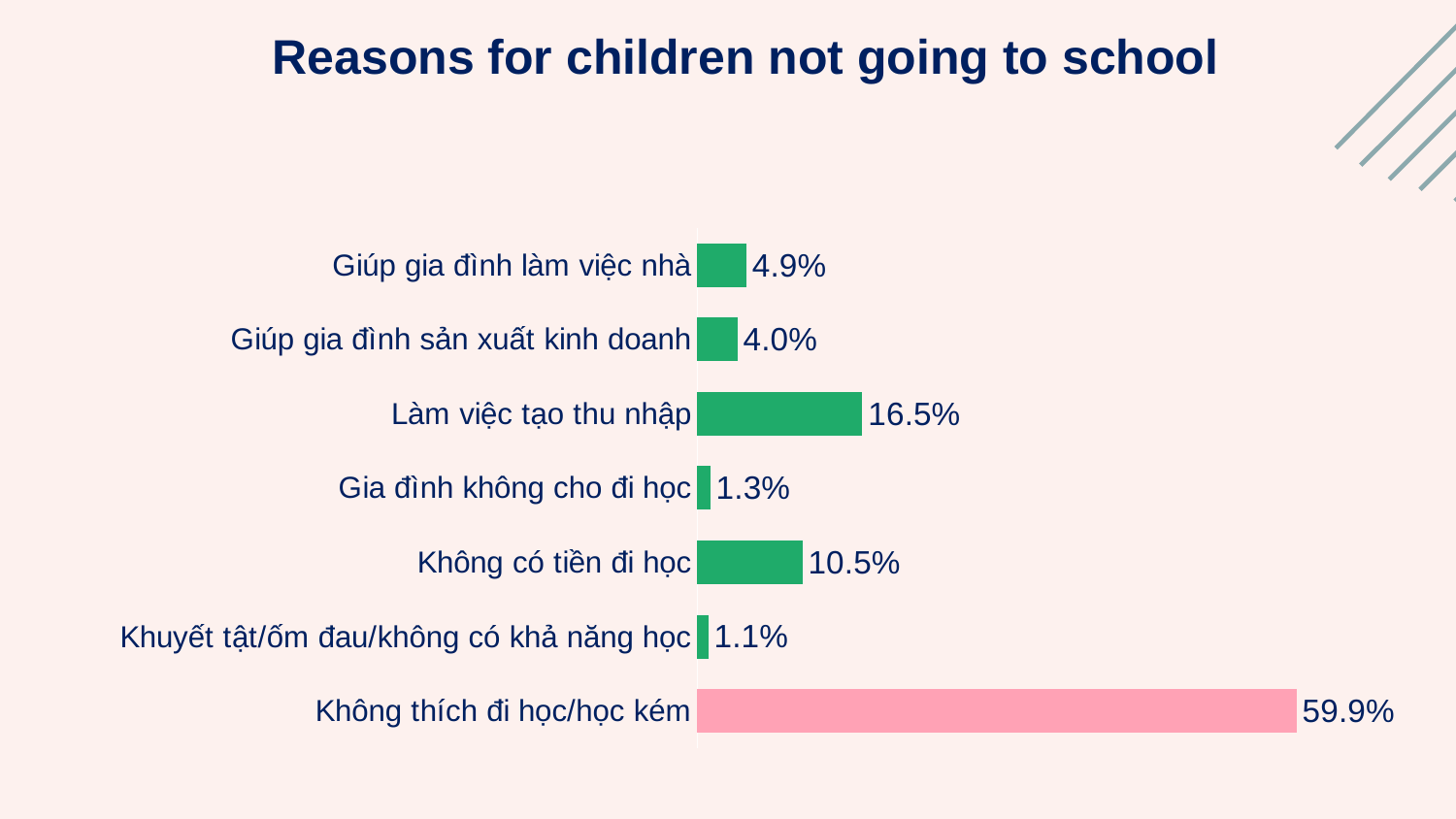
What is the value for "Không thích đi học/học kém"? 59.9% What is the difference between the values for "Làm việc tạo thu nhập" and "Không có tiền đi học"? 6.0% What is the difference between the values for "Giúp gia đình làm việc nhà" and "Giúp gia đình sản xuất kinh doanh"? 0.9% What is the value for "Không có tiền đi học"? 10.5% How many categories are shown in the chart? 7 What is the value for "Làm việc tạo thu nhập"? 16.5% Which is larger, the value for "Gia đình không cho đi học" or the value for "Không có tiền đi học"? Không có tiền đi học What is the title of the chart? Reasons for children not going to school What kind of chart is shown on the slide? Bar chart Which category has the highest value? Không thích đi học/học kém Which category has the lowest value? Khuyết tật/ốm đau/không có khả năng học What is the value for "Giúp gia đình sản xuất kinh doanh"? 4.0%